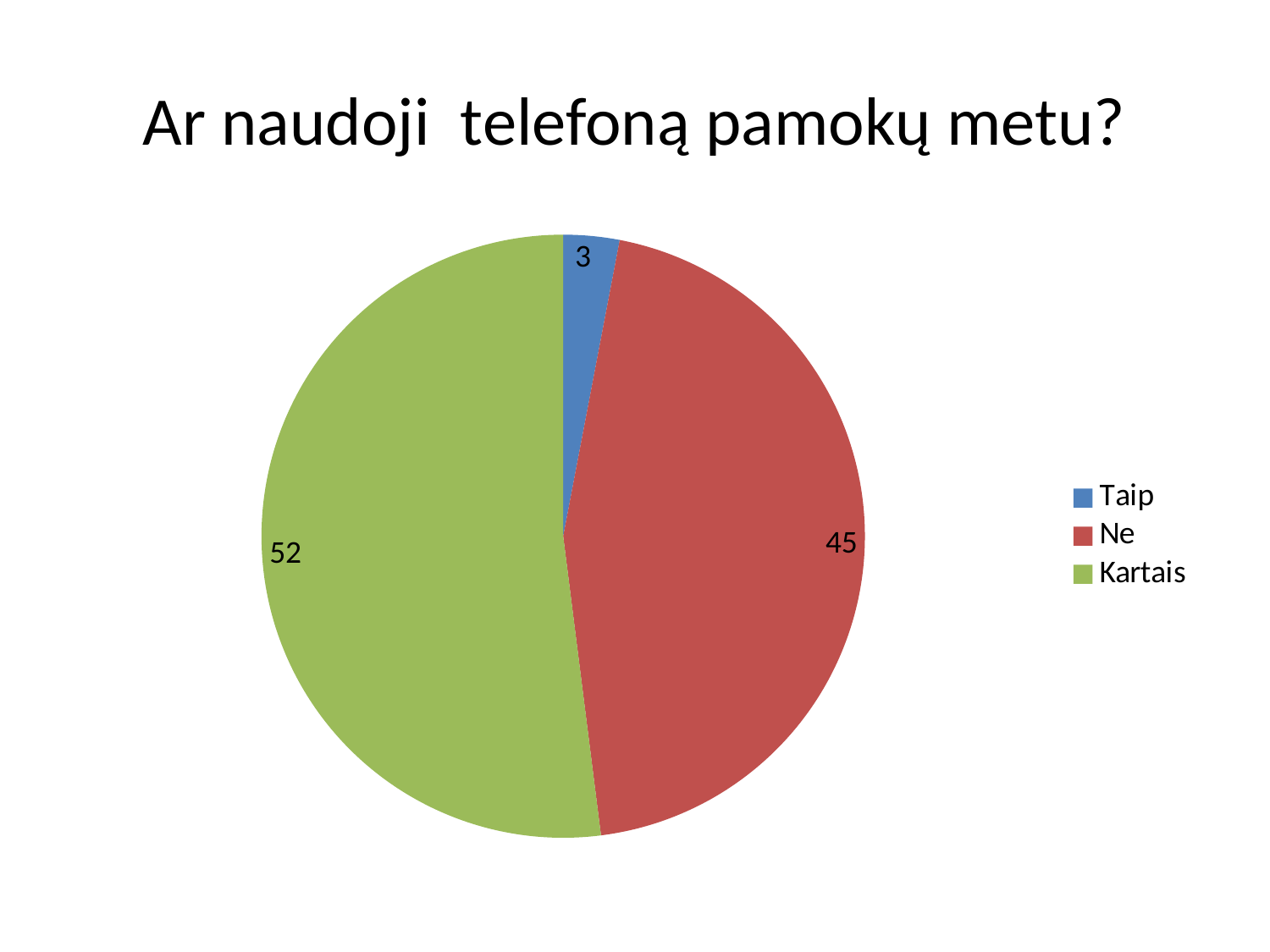
What is the value for "Ne"? 45 What is the difference between the values for "Ne" and "Taip"? 42 Which is larger, the value for "Ne" or the value for "Taip"? Ne What is the difference between the values for "Kartais" and "Ne"? 7 What is the value for "Kartais"? 52 What is the value for "Taip"? 3 What is the title of the chart? Ar naudoji telefoną pamokų metu? What share of the pie does the "Kartais" slice represent? 52% How many slices does the pie chart have? 3 Which category has the smallest slice? Taip Which category has the largest slice? Kartais What type of chart is shown on the slide? pie chart